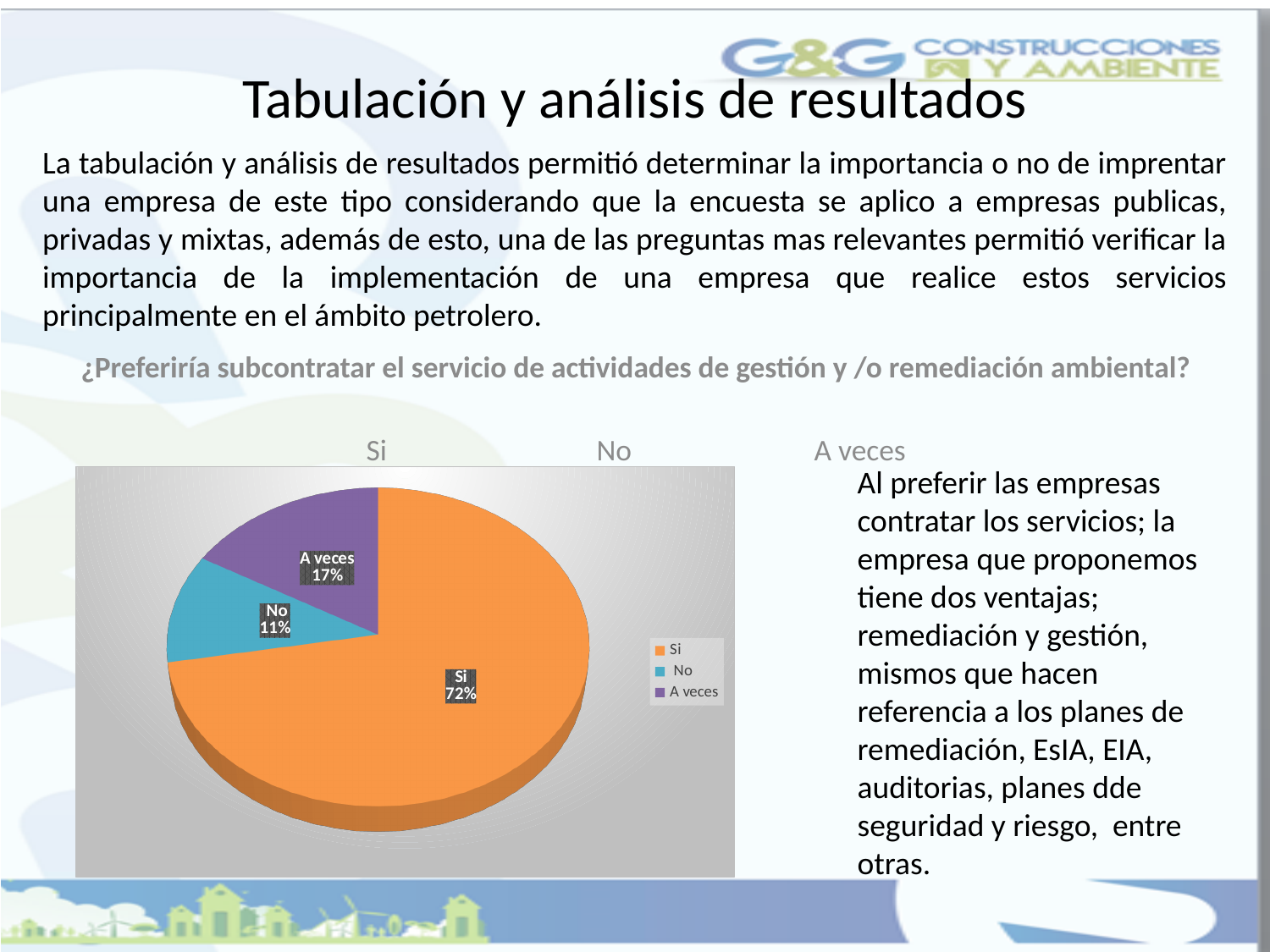
Which is larger in the pie chart, the "No" slice or the "A veces" slice? A veces What colour is the "Si" slice in the pie chart? orange Which slice of the pie chart is the smallest? No What kind of chart is shown on the slide? pie chart How many slices does the pie chart have? 3 What is the difference in percentage points between the "Si" slice and the "A veces" slice? 55 What percentage of the pie chart is labelled "A veces"? 17% How many entries does the legend of the pie chart list? 3 What question does the pie chart present results for? ¿Preferiría subcontratar el servicio de actividades de gestión y /o remediación ambiental? What percentage of the pie chart is labelled "Si"? 72% Which slice of the pie chart is the largest? Si What percentage of the pie chart is labelled "No"? 11%